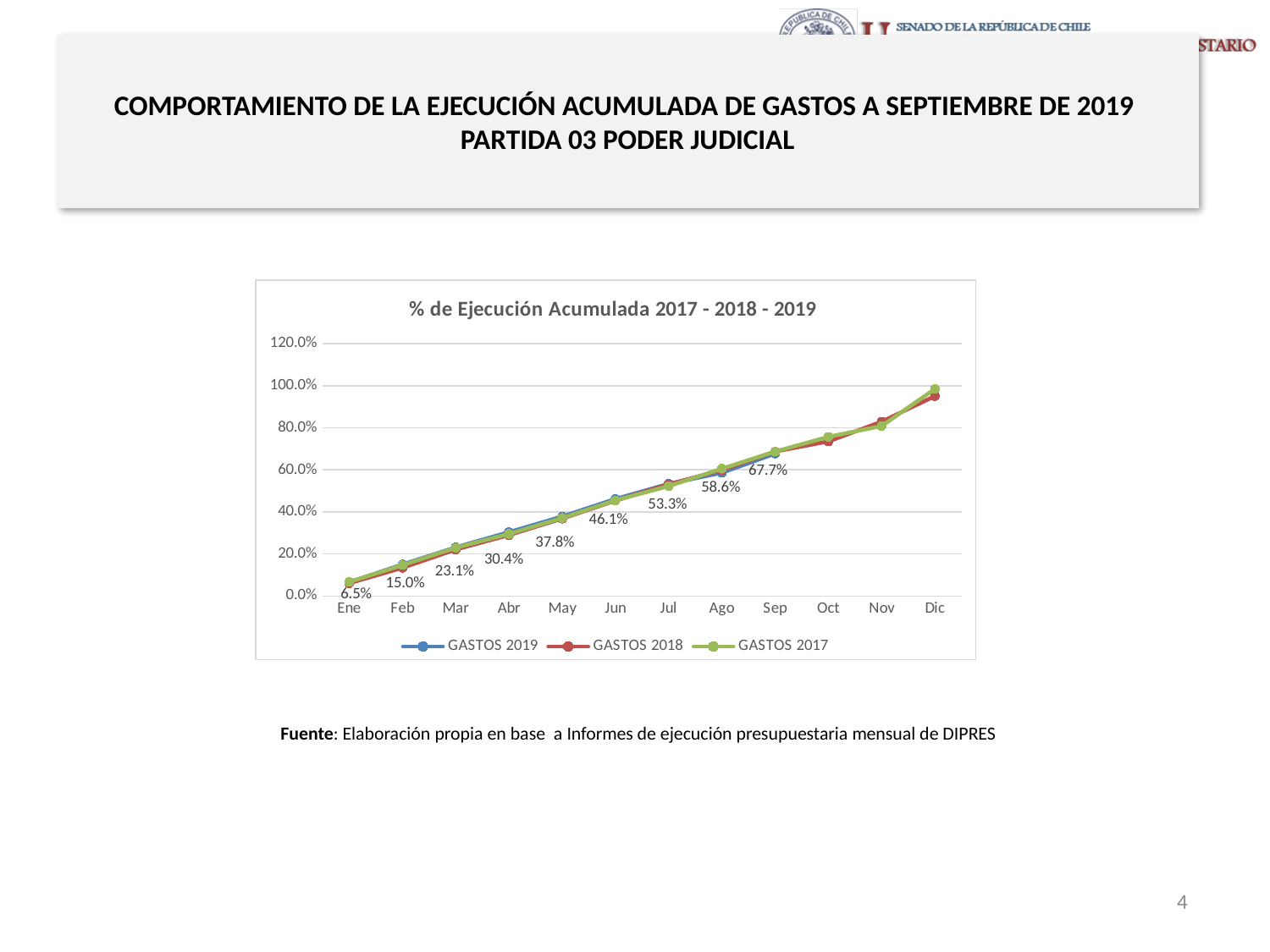
What is the labelled value for GASTOS 2019 in Ene? 6.5% What is the labelled value for GASTOS 2019 in Sep? 67.7% What type of chart is shown on the slide? line chart What is the difference between the GASTOS 2019 values for Sep (67.7%) and Ago (58.6%)? 9.1% Do the GASTOS 2019 values rise or fall from Ene to Sep? rise How many months are shown on the x axis of the chart? 12 Which series is shown in green in the legend? GASTOS 2017 Is the value for GASTOS 2017 in Dic greater or less than 80.0%? greater What is the labelled value for GASTOS 2019 in May? 37.8% What is the title of the chart? % de Ejecución Acumulada 2017 - 2018 - 2019 What is the labelled value for GASTOS 2019 in Jul? 53.3% How many series does the chart legend list? 3